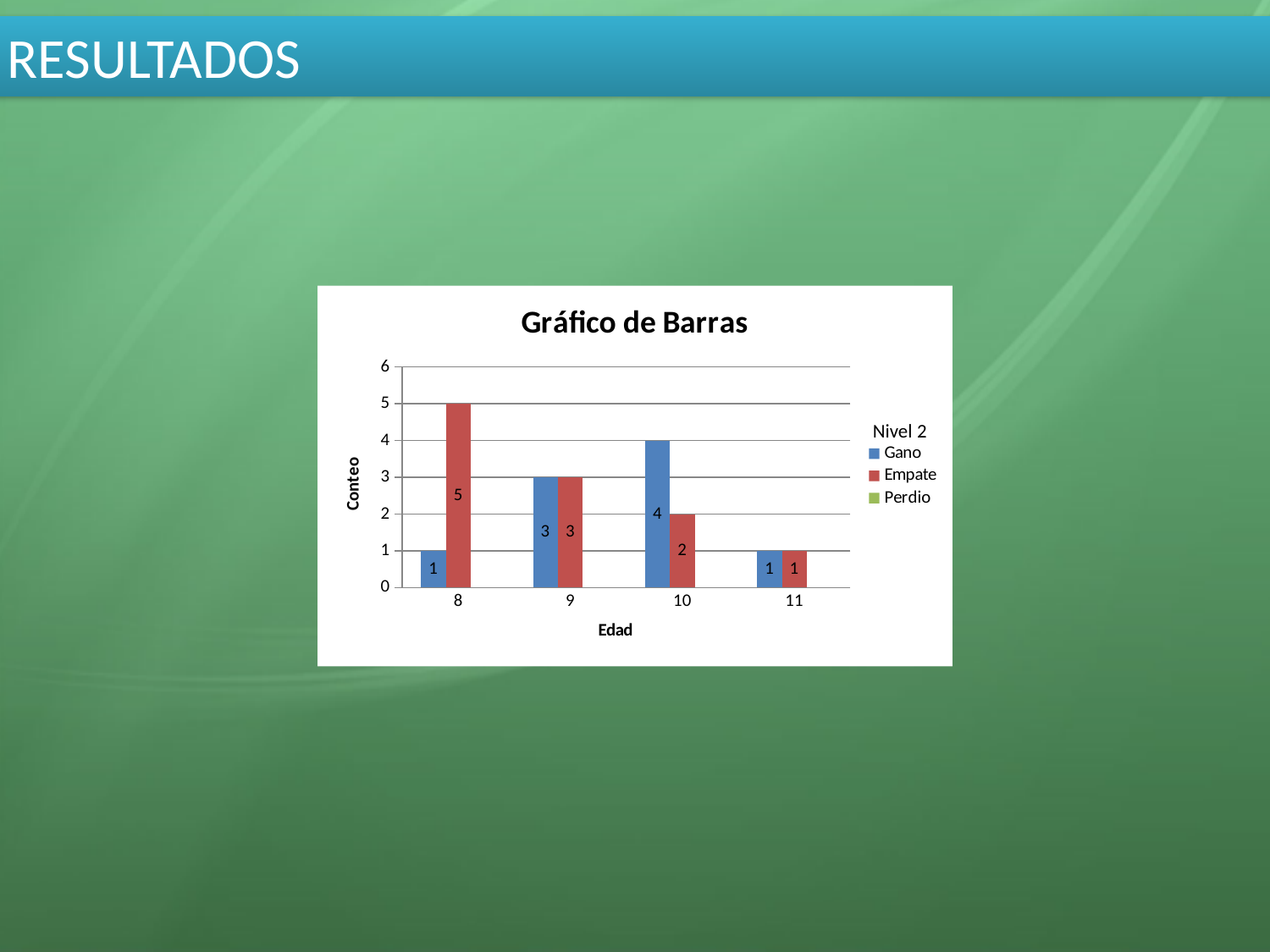
Which is larger at Edad 10, Gano or Empate? Gano How many series does the legend list? 3 What is the value for Empate at Edad 8? 5 What is the value for Empate at Edad 11? 1 At which Edad is the Gano value lowest? 8 and 11 (both 1) What is the value for Gano at Edad 10? 4 What kind of chart is shown? bar chart What is the difference between Empate and Gano at Edad 8? 4 What is the value for Gano at Edad 9? 3 At which Edad is the Empate value highest? 8 What is the title of the chart? Gráfico de Barras How many Edad categories are shown on the x axis? 4